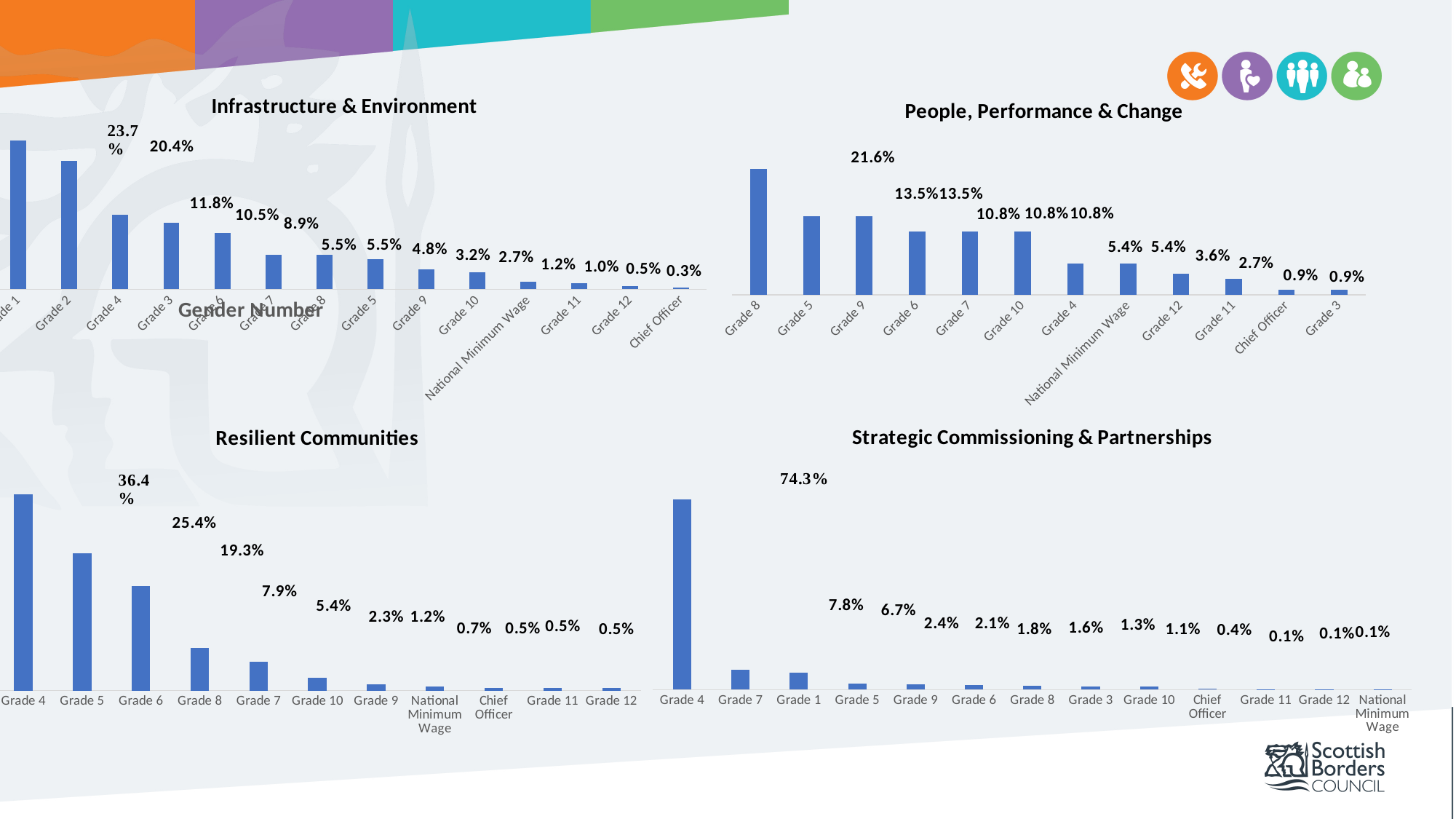
In the Strategic Commissioning & Partnerships chart, which is larger, Grade 5 or Grade 9? Grade 5 In the Strategic Commissioning & Partnerships chart, what is the value for Grade 4? 74.3% In the Resilient Communities chart, which is larger, Grade 8 or Grade 7? Grade 8 What type of chart is the Resilient Communities chart? Bar chart In the People, Performance & Change chart, what is the value for Grade 8? 21.6% How many categories are shown in the Resilient Communities chart? 11 In the Strategic Commissioning & Partnerships chart, what is the difference between Grade 7 and Grade 1? 1.1% In the Resilient Communities chart, which category has the highest value? Grade 4 In the Resilient Communities chart, what is the value for Grade 6? 19.3% How many categories are shown in the Strategic Commissioning & Partnerships chart? 13 In the Resilient Communities chart, what is the difference between Grade 4 and Grade 5? 11.0% In the People, Performance & Change chart, which category has the highest value? Grade 8